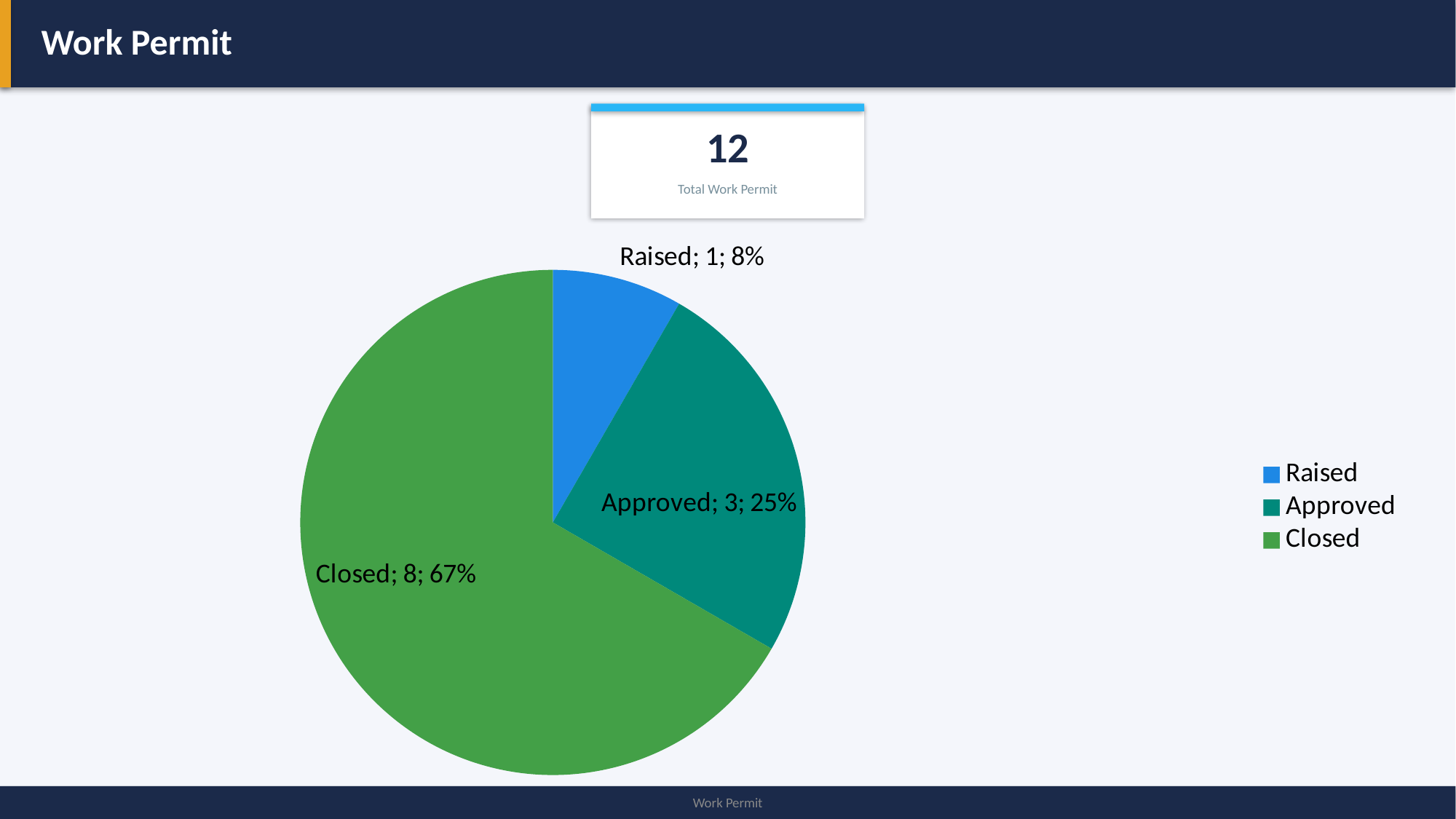
How many categories does the legend list? 3 Which is larger, the Approved slice or the Raised slice? Approved What share of the pie does the Raised slice represent? 8% Which category has the smallest slice of the pie? Raised What share of the pie does the Approved slice represent? 25% What is the difference between the number of Closed and Approved work permits? 5 What kind of chart is shown on the slide? pie chart How many work permits are Closed? 8 How many work permits are Approved? 3 How many work permits are Raised? 1 What share of the pie does the Closed slice represent? 67% Which category has the largest slice of the pie? Closed